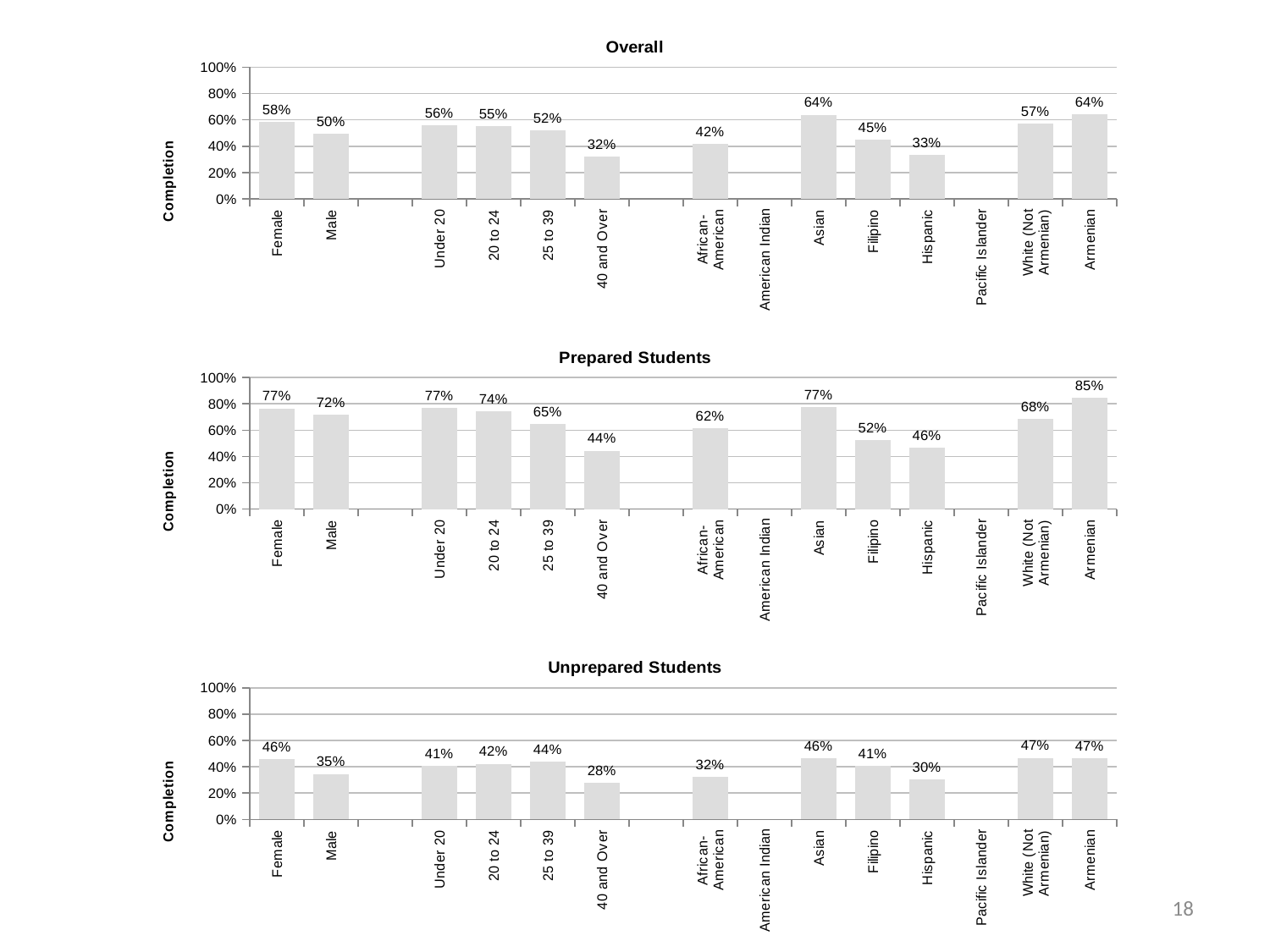
In the Overall chart, which has a higher completion rate, Under 20 or 40 and Over? Under 20 In the Unprepared Students chart, what is the completion rate for students aged 40 and Over? 28% In the Prepared Students chart, what is the completion rate for Hispanic students? 46% What is the y-axis label on the Prepared Students chart? Completion In the Overall chart, what is the difference between the completion rates for Female and Male students? 8% In the Unprepared Students chart, is the completion rate for Male students greater or less than 40%? less In the Prepared Students chart, which category has the highest completion rate? Armenian How many charts are shown on the slide? 3 In the Unprepared Students chart, what is the difference between the completion rates for Asian and Hispanic students? 16% What type of chart is the Overall chart? bar chart In the Overall chart, what is the completion rate for Female students? 58% In the Prepared Students chart, is the completion rate for Filipino students greater or less than 60%? less